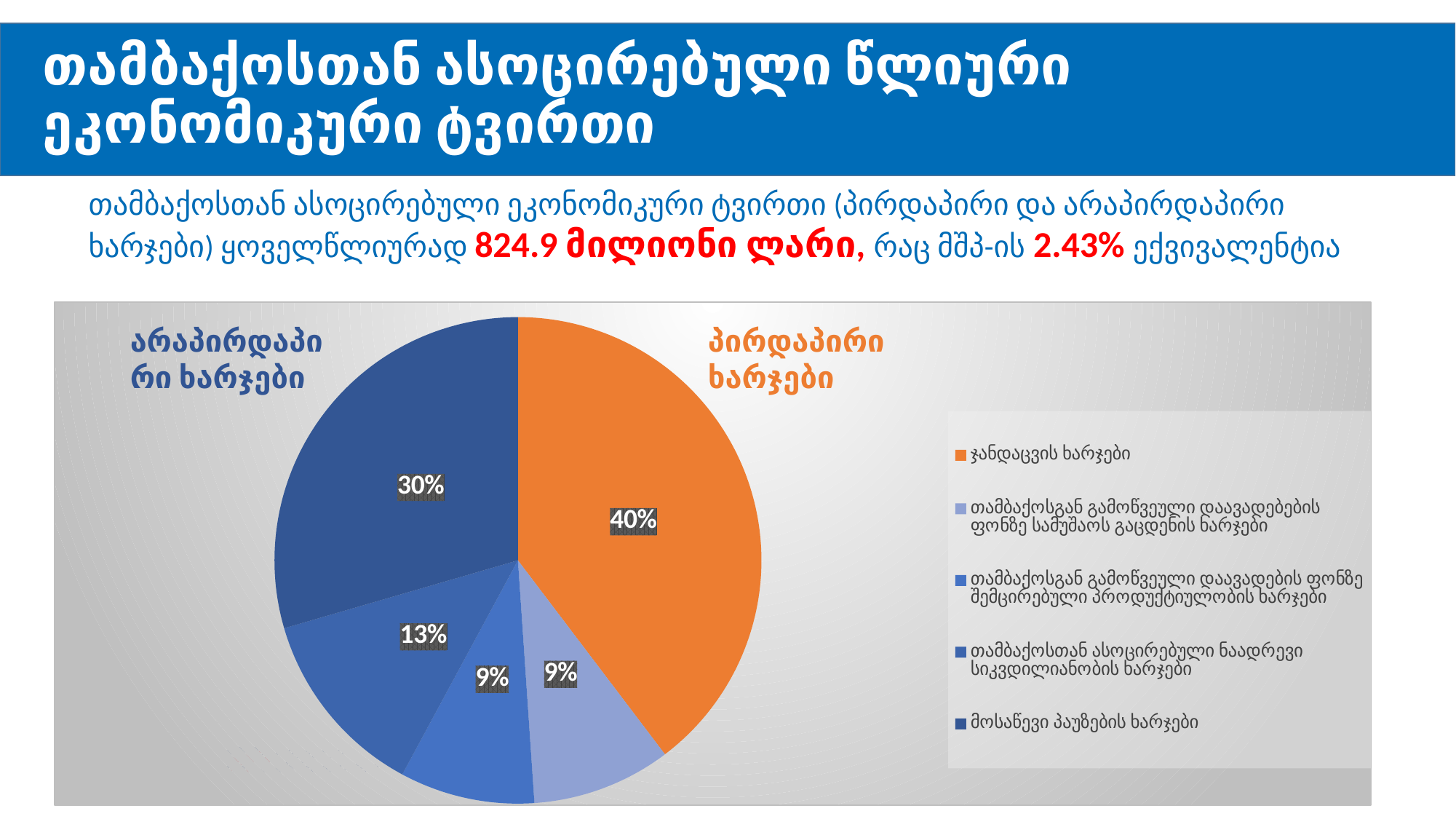
What share of the pie does მოსაწევი პაუზების ხარჯები (the dark blue slice) have? 30% Which category has the largest slice of the pie? ჯანდაცვის ხარჯები What colour is the slice labelled პირდაპირი ხარჯები? orange What is the difference in percentage points between the ჯანდაცვის ხარჯები slice and the მოსაწევი პაუზების ხარჯები slice? 10 percentage points What is the combined share of the two 9% slices and the 13% slice? 31% How many entries does the legend of the pie chart list? 5 What share of the pie does თამბაქოსგან გამოწვეული დაავადებების ფონზე სამუშაოს გაცდენის ხარჯები (the light blue slice) have? 9% How many slices does the pie chart have? 5 What share of the pie does ჯანდაცვის ხარჯები (the orange slice) have? 40% Which is larger: the slice for მოსაწევი პაუზების ხარჯები or the slice for თამბაქოსთან ასოცირებული ნაადრევი სიკვდილიანობის ხარჯები? მოსაწევი პაუზების ხარჯები What kind of chart is shown on the slide? pie chart